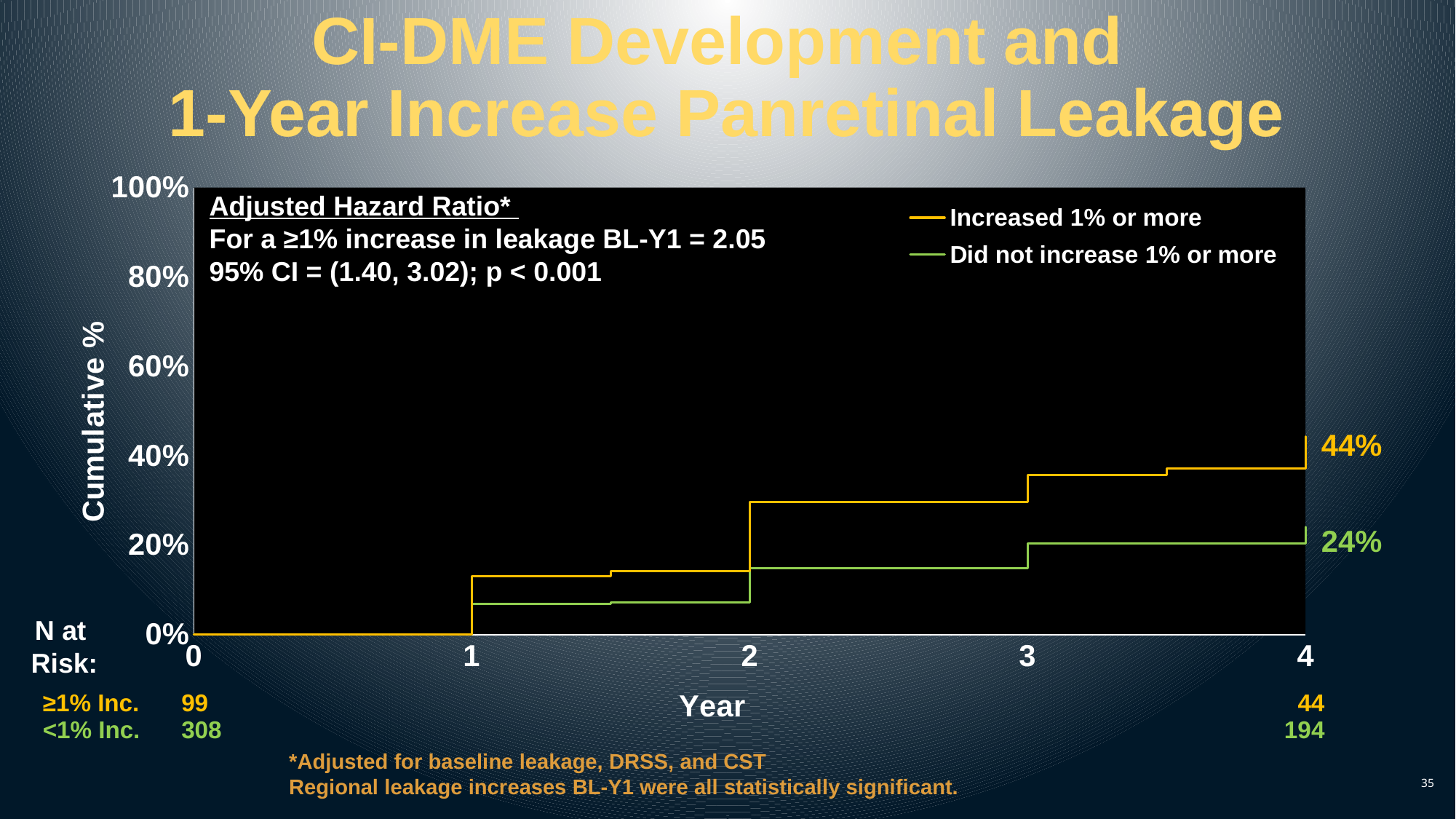
Which group has the higher cumulative % at year 4? Increased 1% or more Do the cumulative % values rise or fall as the year increases? rise What is the cumulative % at year 4 for the 'Did not increase 1% or more' group? 24% What is the N at risk for the ≥1% Inc. group at year 0? 99 What is the label of the y axis? Cumulative % What is the cumulative % at year 4 for the 'Increased 1% or more' group? 44% How many series does the legend list? 2 What is the difference between the year-4 cumulative % of the 'Increased 1% or more' group and the 'Did not increase 1% or more' group? 20% What kind of chart is shown on the slide? line chart What is the N at risk for the <1% Inc. group at year 4? 194 Is the cumulative % for the 'Did not increase 1% or more' group at year 2 greater or less than 20%? less